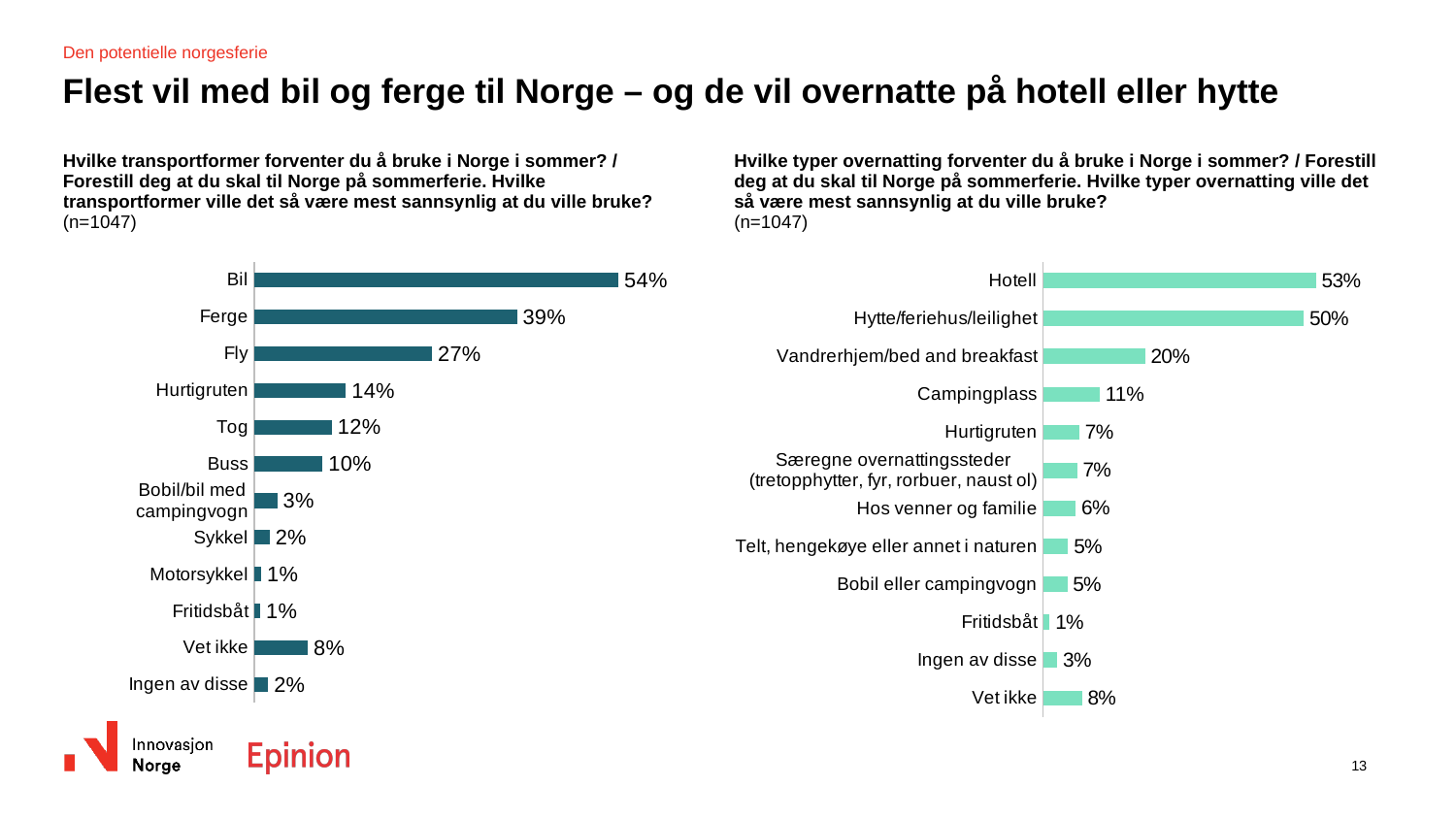
In the right chart (accommodation types), what is the value for Hytte/feriehus/leilighet? 50% In the right chart (accommodation types), which category has the lowest value? Fritidsbåt In the left chart (transport forms), which category has the highest value? Bil In the right chart (accommodation types), how many categories are shown? 12 In the left chart (transport forms), what is the difference between Bil and Fly? 27% In the left chart (transport forms), how many categories are shown? 12 What type of chart is the right chart (accommodation types)? Bar chart In the left chart (transport forms), what is the value for Ferge? 39% In the left chart (transport forms), what is the value for Vet ikke? 8% In the left chart (transport forms), which is larger: Tog or Buss? Tog In the right chart (accommodation types), what is the difference between Hotell and Vandrerhjem/bed and breakfast? 33% In the right chart (accommodation types), which is larger: Campingplass or Hos venner og familie? Campingplass